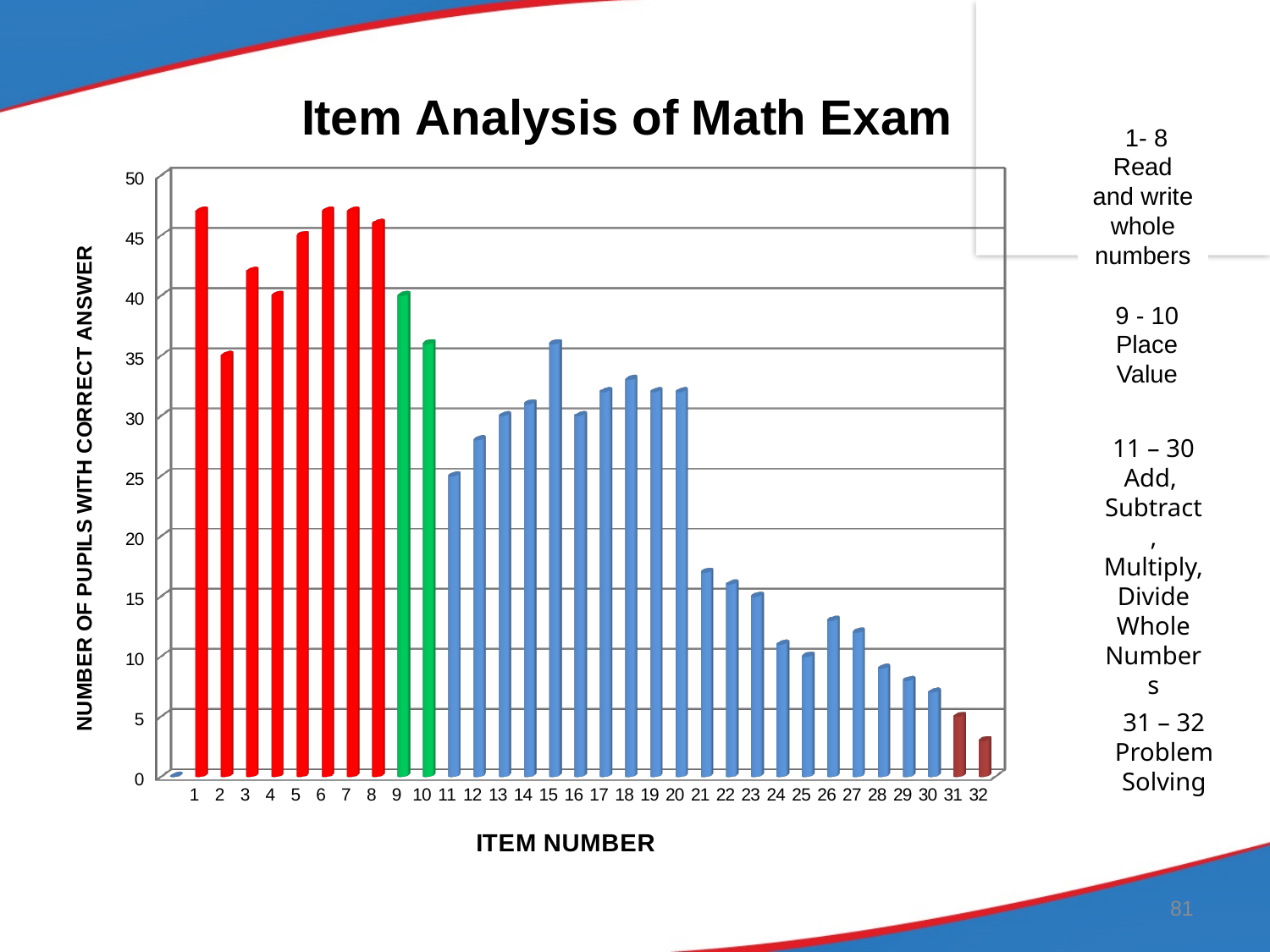
Is the value for item 21 greater or less than 20? less Is the value for item 32 greater or less than 5? less How many item numbers are plotted along the x axis? 32 Do the values generally rise or fall from item 21 to item 32? fall What kind of chart is shown on the slide? bar chart Which has more pupils with the correct answer, item 15 or item 11? item 15 Which has more pupils with the correct answer, item 3 or item 2? item 3 Is the value for item 15 greater or less than 35? greater What is the label of the y axis? NUMBER OF PUPILS WITH CORRECT ANSWER What is the title of the chart? Item Analysis of Math Exam Which item number has the lowest number of pupils with the correct answer? 32